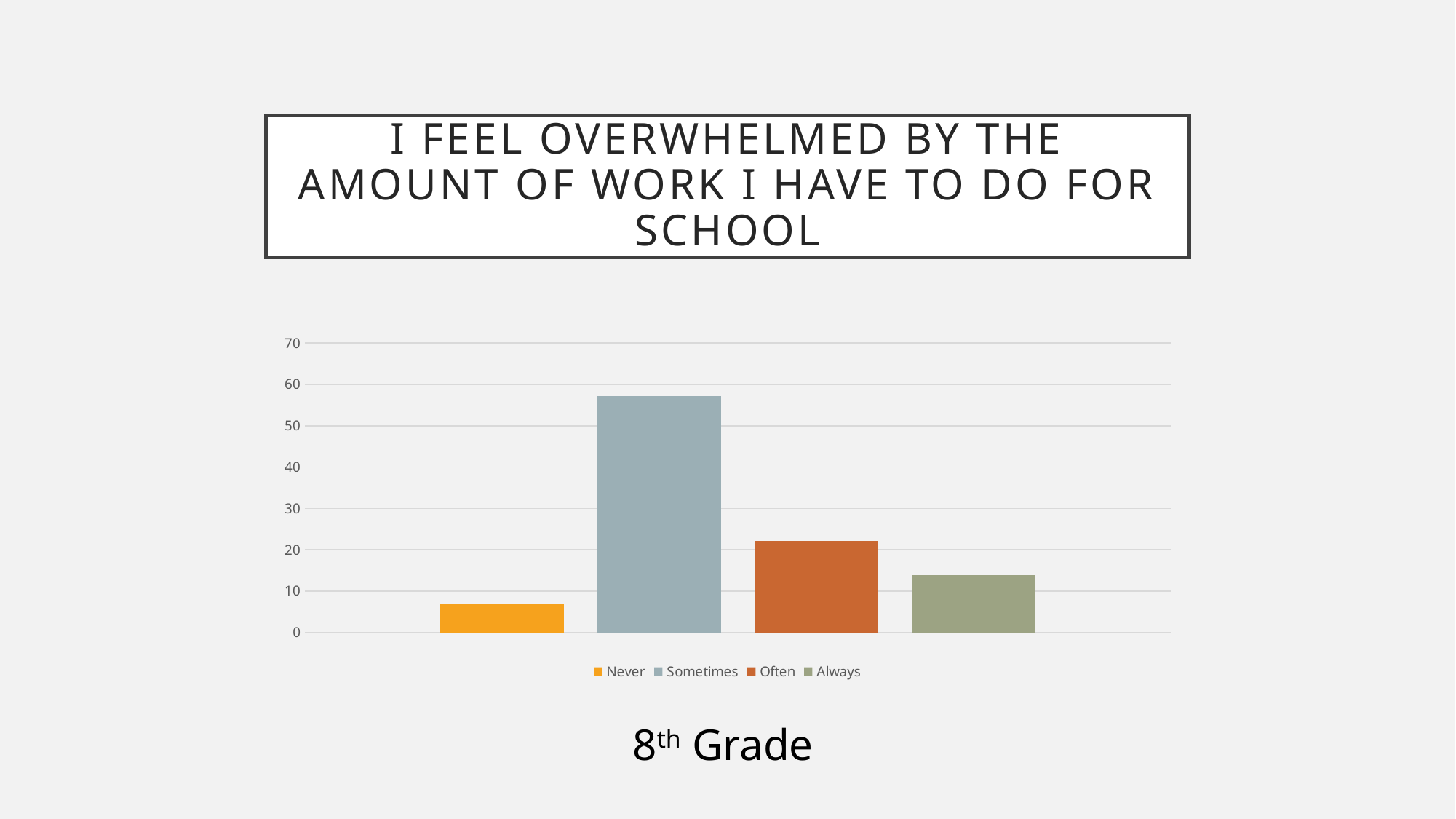
Is the value for Often greater or less than 20? greater What kind of chart is shown on the slide? bar chart How many entries does the legend list? 4 Is the value for Sometimes greater or less than 50? greater Which grade level does the chart represent, according to the label below it? 8th Grade Which response category has the lowest bar? Never Is the value for Always greater or less than 20? less Which response category has the highest bar? Sometimes Which is larger, the value for Often or the value for Always? Often How many bars are plotted in the chart? 4 Which is larger, the value for Never or the value for Always? Always